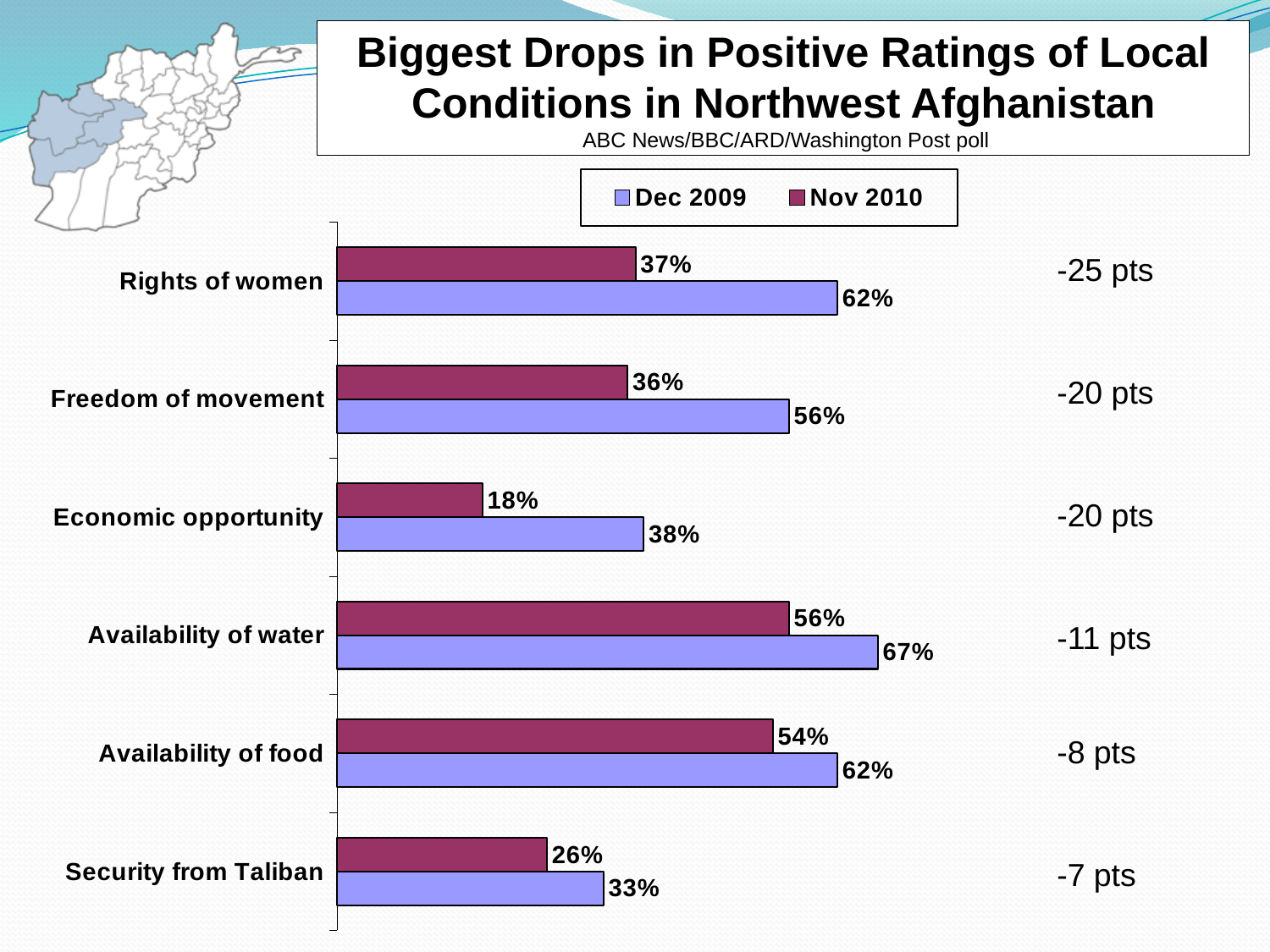
What is the Nov 2010 value for Economic opportunity? 18% Which is larger: the Nov 2010 value for Availability of food or the Nov 2010 value for Availability of water? Availability of water How many series does the legend list? 2 What is the Dec 2009 value for Availability of water? 67% How many categories are shown on the chart? 6 Which category has the lowest Nov 2010 value? Economic opportunity What is the difference between the Dec 2009 and Nov 2010 values for Freedom of movement? 20 percentage points Which category has the highest Dec 2009 value? Availability of water What kind of chart is shown on the slide? Bar chart What is the Nov 2010 value for Rights of women? 37% Which poll is credited as the source of the chart? ABC News/BBC/ARD/Washington Post poll What is the Dec 2009 value for Security from Taliban? 33%